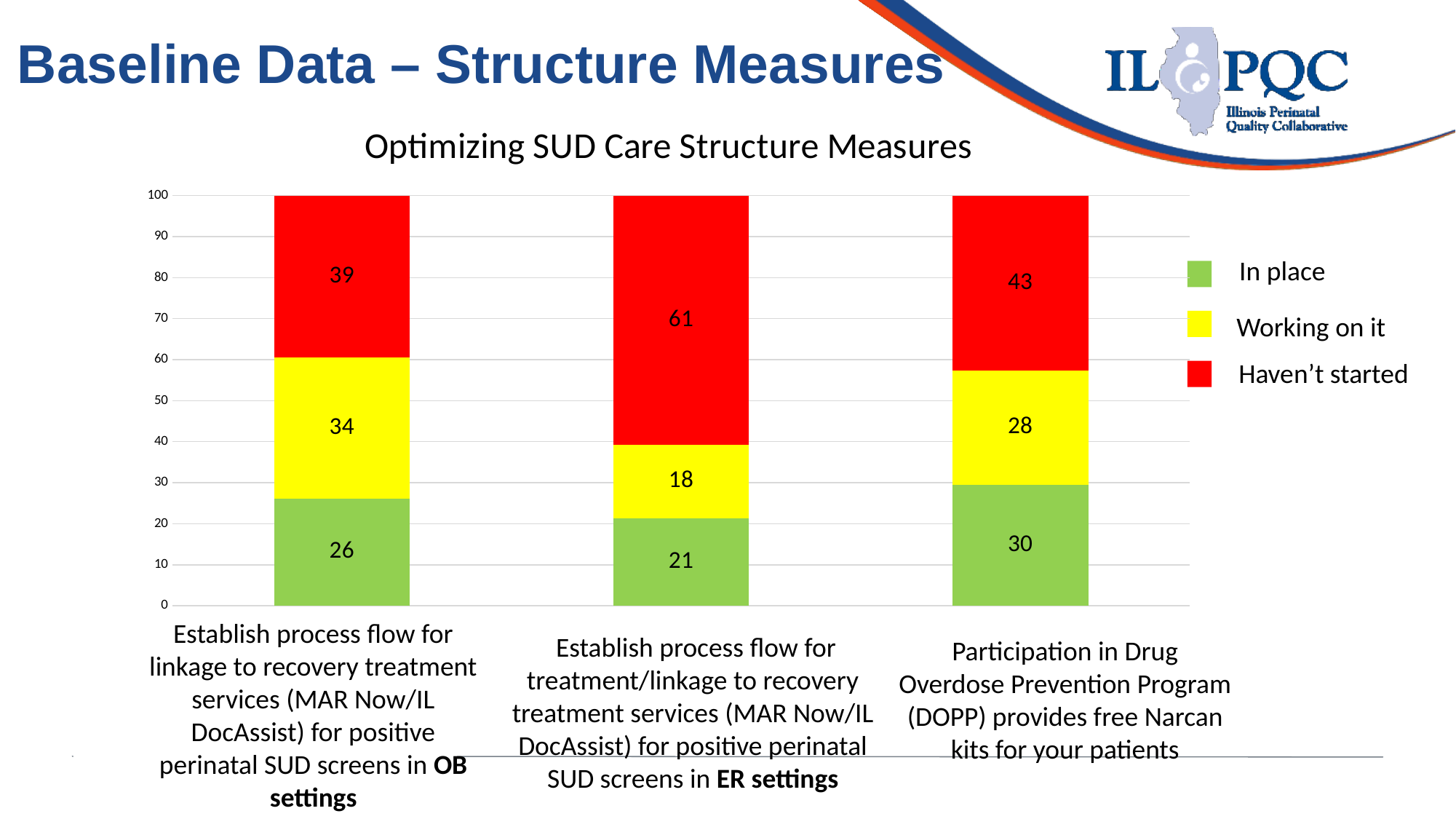
Which category has the highest 'Haven't started' value? Establish process flow for treatment/linkage to recovery treatment services in ER settings How many series does the legend list? 3 What is the difference between the 'Haven't started' values for the ER settings measure and the OB settings measure? 22 Which colour represents 'Working on it' in the chart? Yellow Which category has the lowest 'In place' value? Establish process flow for treatment/linkage to recovery treatment services in ER settings What is the 'Working on it' value for Participation in Drug Overdose Prevention Program (DOPP)? 28 What is the 'Haven't started' value for the ER settings process flow measure? 61 What kind of chart is shown on the slide? Stacked bar chart Is the 'In place' value larger for the DOPP participation measure or for the OB settings measure? DOPP participation measure What is the title of the chart? Optimizing SUD Care Structure Measures How many categories (bars) are shown on the x axis? 3 What is the 'In place' value for the OB settings process flow measure? 26